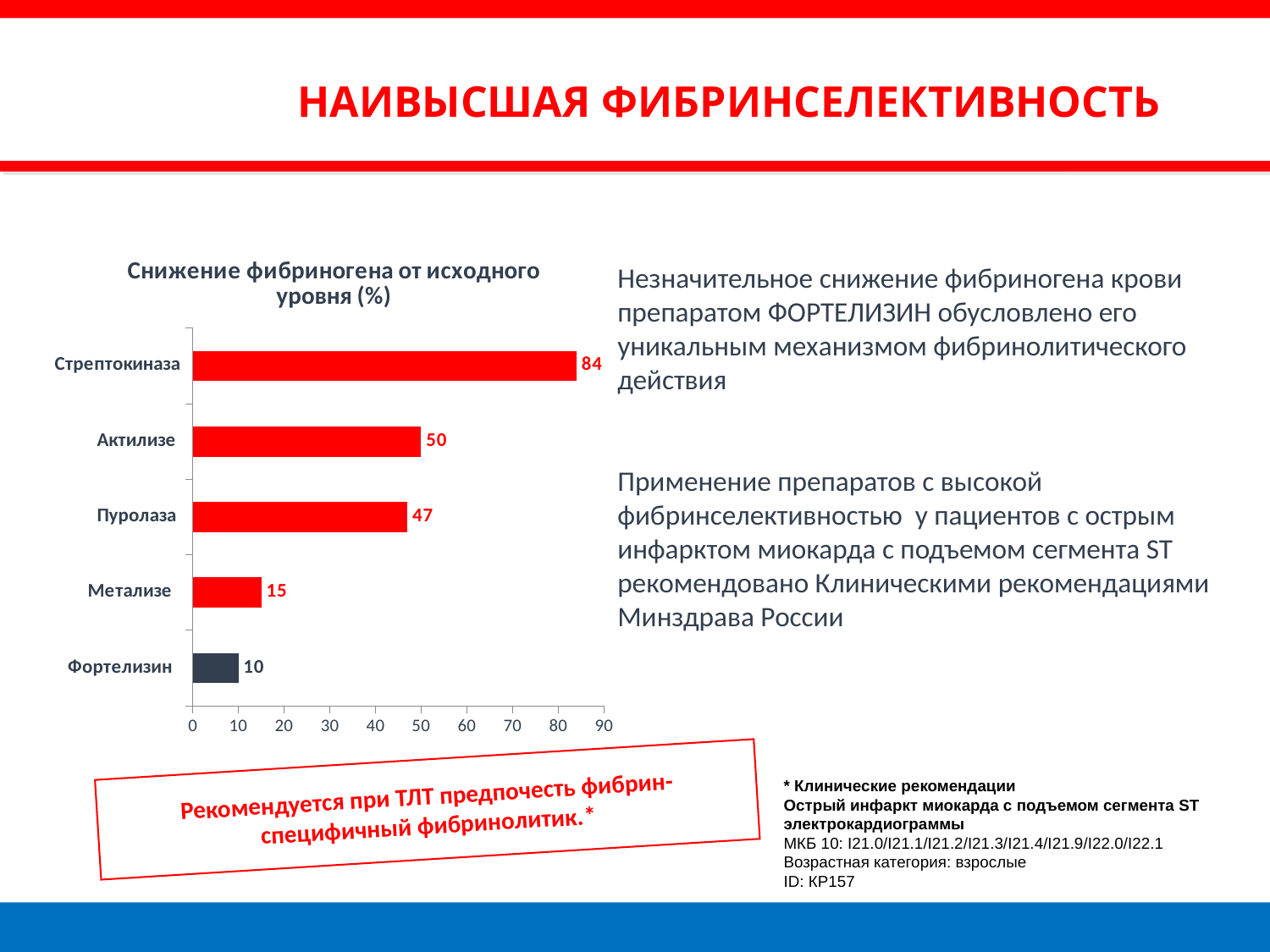
What is the value for Пуролаза? 47 What is the value for Стрептокиназа? 84 What is the difference between the values for Стрептокиназа and Актилизе? 34 Is the value for Метализе greater or less than 20? less Which is larger, the value for Актилизе or the value for Пуролаза? Актилизе Which category has the lowest value? Фортелизин What is the difference between the values for Метализе and Фортелизин? 5 What is the value for Фортелизин? 10 Which category has the highest value? Стрептокиназа How many categories are shown in the chart? 5 What kind of chart is shown on the slide? bar chart What is the title of the chart? Снижение фибриногена от исходного уровня (%)